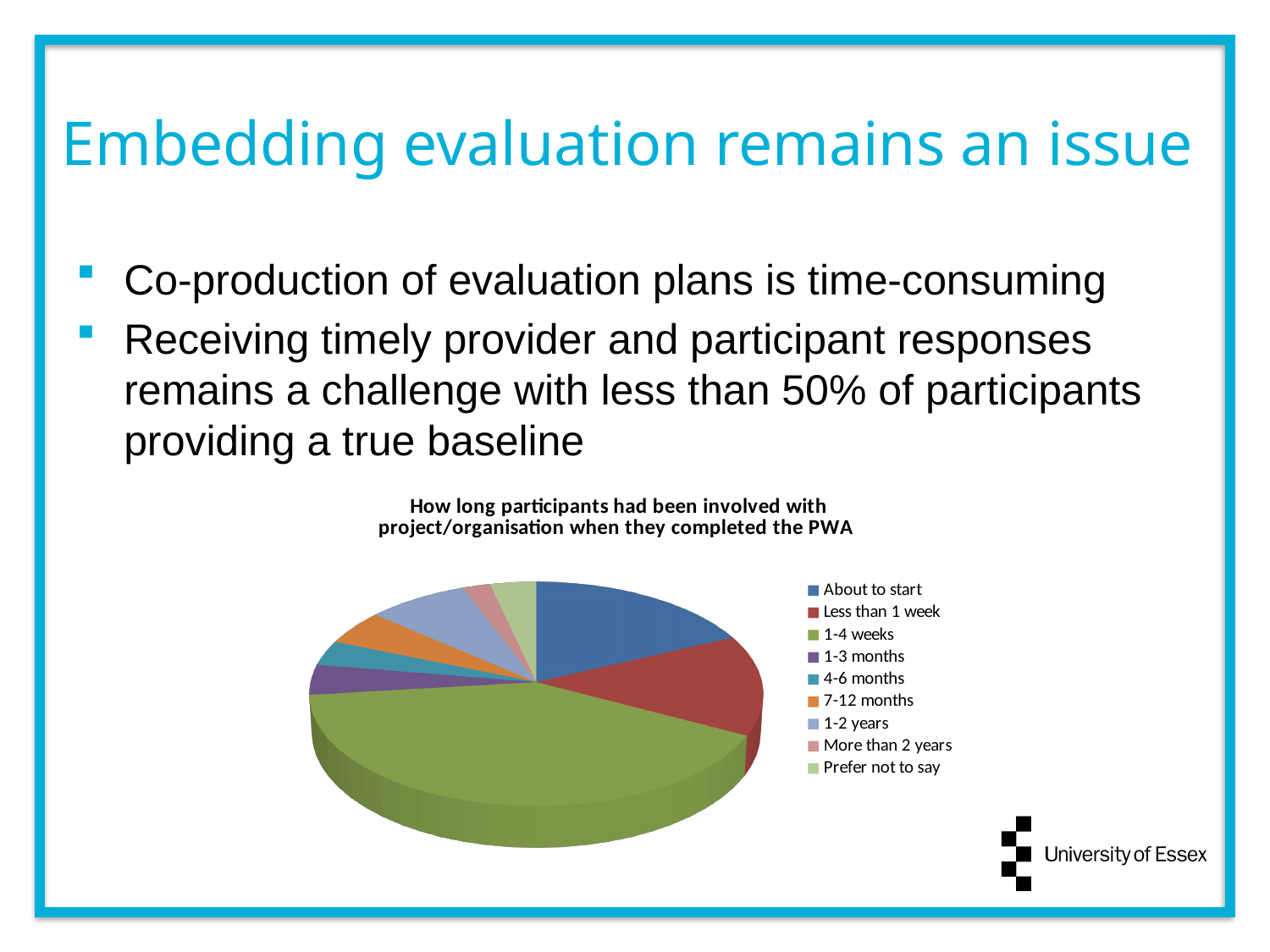
Which slice is larger in the pie chart: About to start or 1-3 months? About to start Which slice is larger in the pie chart: 1-4 weeks or About to start? 1-4 weeks Which category has the largest slice in the pie chart? 1-4 weeks What kind of chart is shown on the slide? Pie chart Which category is listed first in the pie chart's legend? About to start What is the title of the pie chart? How long participants had been involved with project/organisation when they completed the PWA Which category is listed last in the pie chart's legend? Prefer not to say Which slice is larger in the pie chart: Less than 1 week or 4-6 months? Less than 1 week What colour is the 1-4 weeks slice in the pie chart? Green How many categories does the pie chart's legend list? 9